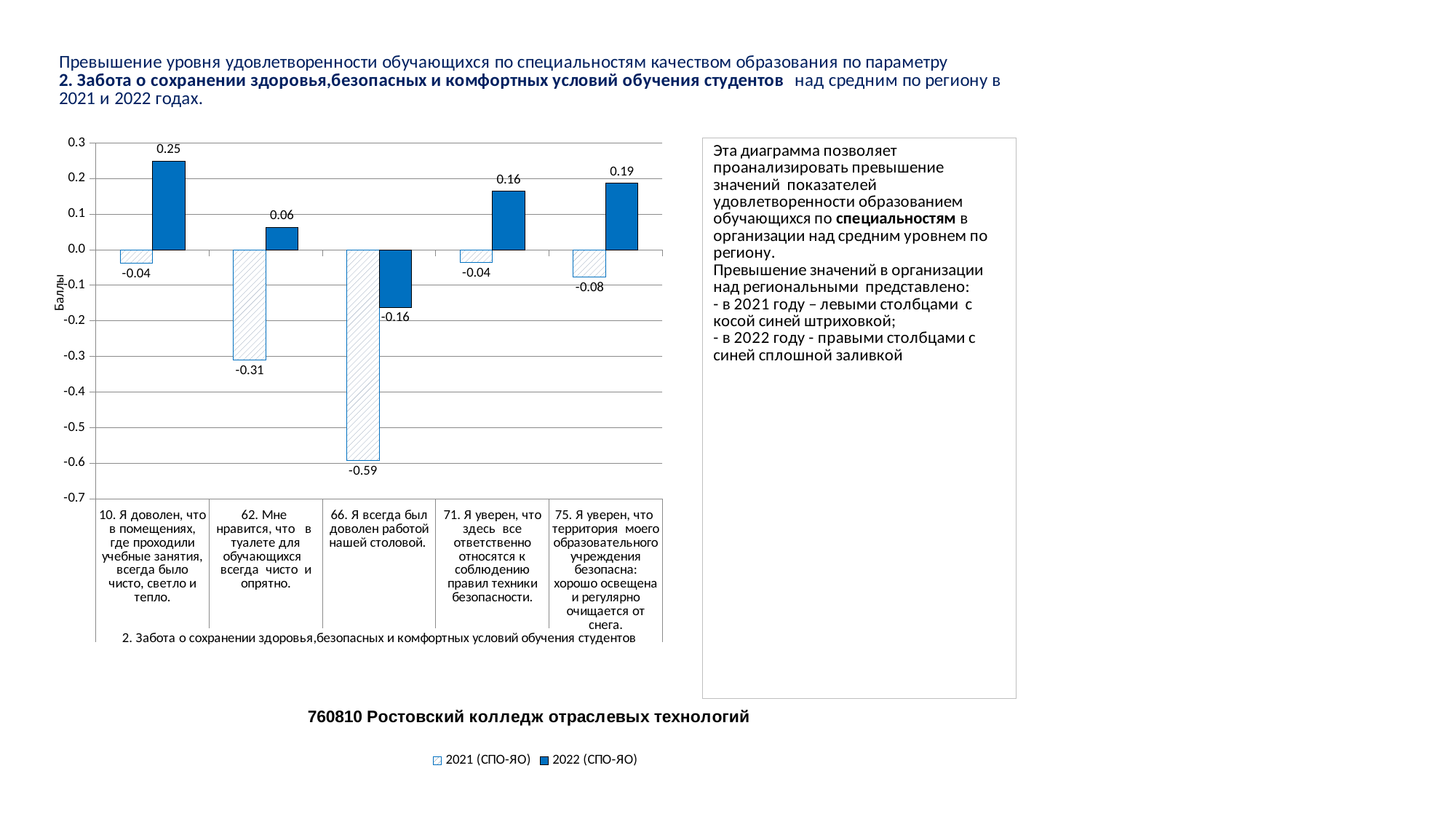
How many series does the legend list? 2 What is the label of the vertical axis? Баллы How many categories (statements) are shown on the x axis? 5 What is the 2021 (СПО-ЯО) value for statement 66 (Я всегда был доволен работой нашей столовой)? -0.59 For statement 71 (Я уверен, что здесь все ответственно относятся к соблюдению правил техники безопасности), which is larger: the 2021 value or the 2022 value? 2022 (СПО-ЯО) What is the difference between the 2022 and 2021 values for statement 66 (Я всегда был доволен работой нашей столовой)? 0.43 Which statement has the lowest 2021 (СПО-ЯО) value? 66. Я всегда был доволен работой нашей столовой. Which statement has the highest 2022 (СПО-ЯО) value? 10. Я доволен, что в помещениях, где проходили учебные занятия, всегда было чисто, светло и тепло. What is the 2021 (СПО-ЯО) value for statement 62 (Мне нравится, что в туалете для обучающихся всегда чисто и опрятно)? -0.31 What is the 2022 (СПО-ЯО) value for statement 75 (Я уверен, что территория моего образовательного учреждения безопасна)? 0.19 What type of chart is shown on the slide? bar chart What is the 2022 (СПО-ЯО) value for statement 10 (Я доволен, что в помещениях, где проходили учебные занятия, всегда было чисто, светло и тепло)? 0.25